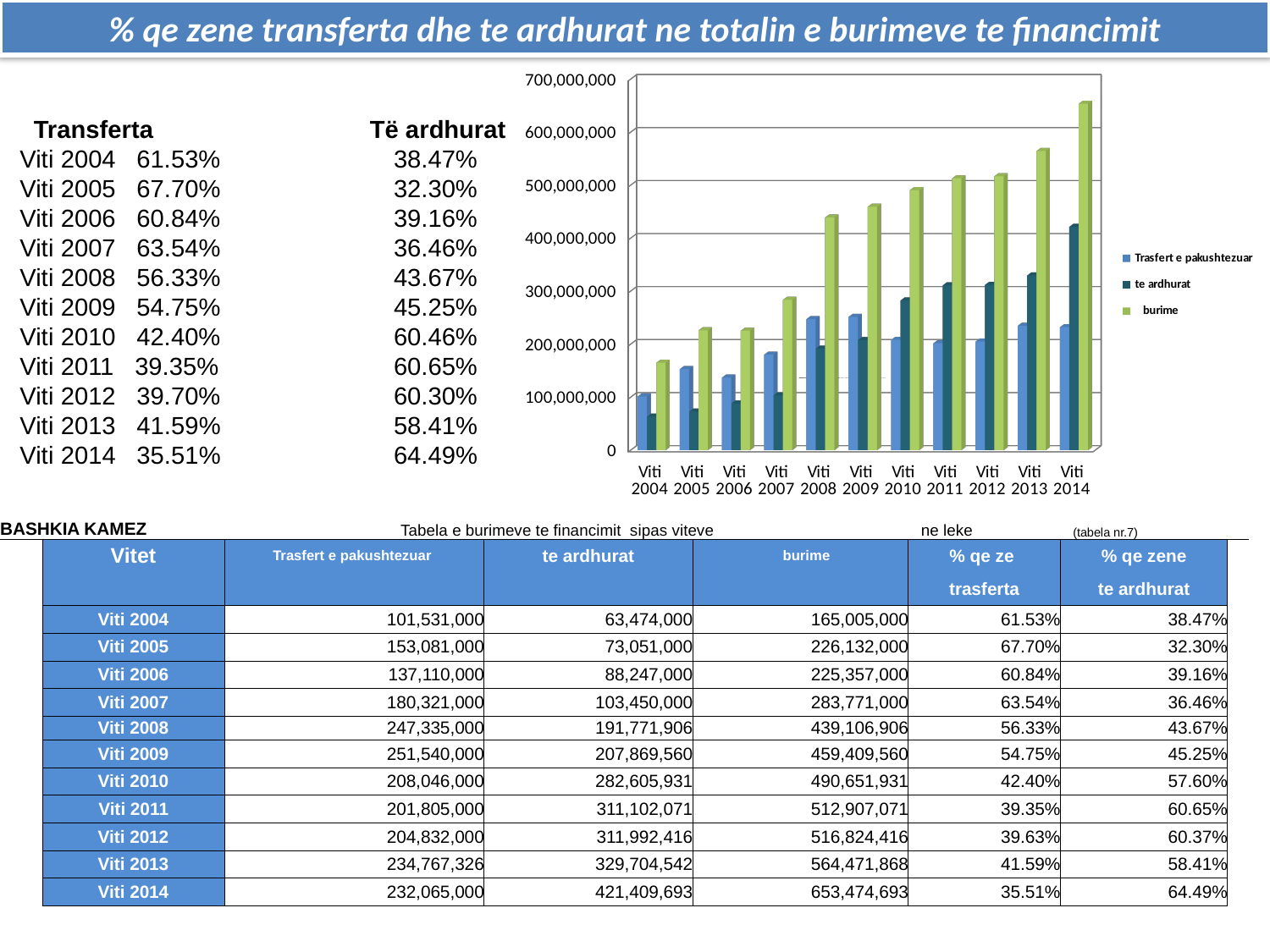
In which year is the 'burime' bar lowest? Viti 2004 Is the 'te ardhurat' value for Viti 2004 greater or less than 100,000,000? less In Viti 2004, which is larger: 'Trasfert e pakushtezuar' or 'te ardhurat'? Trasfert e pakushtezuar What kind of chart is shown on the slide? bar chart How many series does the chart legend list? 3 How many years are shown on the x axis of the chart? 11 Is the 'Trasfert e pakushtezuar' value for Viti 2008 greater or less than 200,000,000? greater In which year is the 'te ardhurat' bar lowest? Viti 2004 In Viti 2014, which is larger: 'Trasfert e pakushtezuar' or 'te ardhurat'? te ardhurat Do the 'burime' values generally rise or fall from Viti 2004 to Viti 2014? rise In which year is the 'burime' bar highest? Viti 2014 Is the 'burime' value for Viti 2014 greater or less than 600,000,000? greater